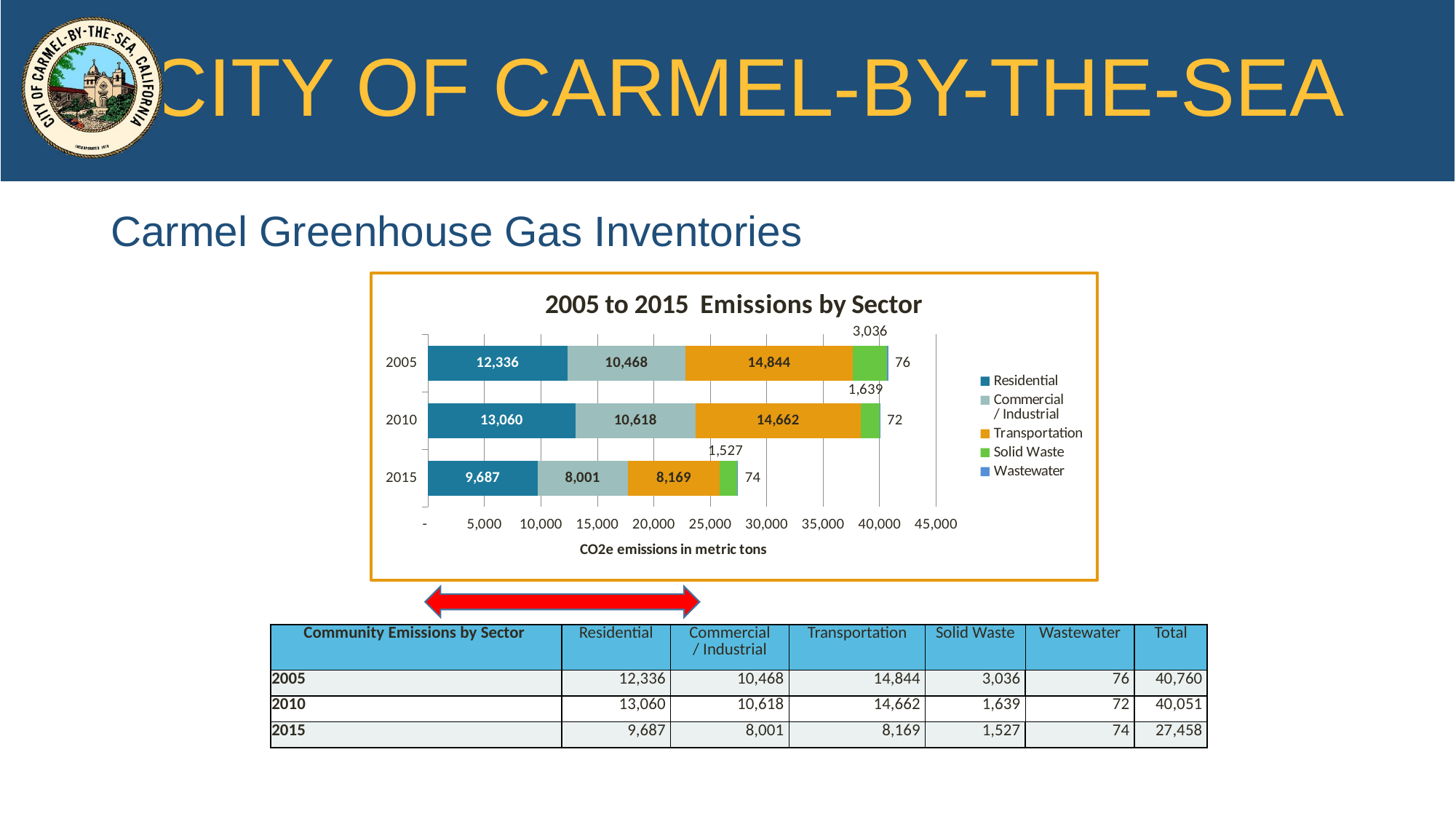
In the 2005 to 2015 Emissions by Sector chart, what is the Residential value for 2005? 12,336 How many years are shown in the 2005 to 2015 Emissions by Sector chart? 3 In the 2005 to 2015 Emissions by Sector chart, which year has the highest Transportation value? 2005 In the 2005 to 2015 Emissions by Sector chart, which year has the lowest Residential value? 2015 How many series does the legend of the 2005 to 2015 Emissions by Sector chart list? 5 What is the x-axis title of the 2005 to 2015 Emissions by Sector chart? CO2e emissions in metric tons In the 2005 to 2015 Emissions by Sector chart, which year has the larger Commercial / Industrial value, 2005 or 2010? 2010 What kind of chart is the 2005 to 2015 Emissions by Sector chart? Stacked bar chart In the 2005 to 2015 Emissions by Sector chart, how much larger is the Residential value in 2010 than in 2005? 724 In the 2005 to 2015 Emissions by Sector chart, what is the Transportation value for 2015? 8,169 In the 2005 to 2015 Emissions by Sector chart, what is the Solid Waste value for 2010? 1,639 In the 2005 to 2015 Emissions by Sector chart, what is the total of the stacked bar for 2015? 27,458